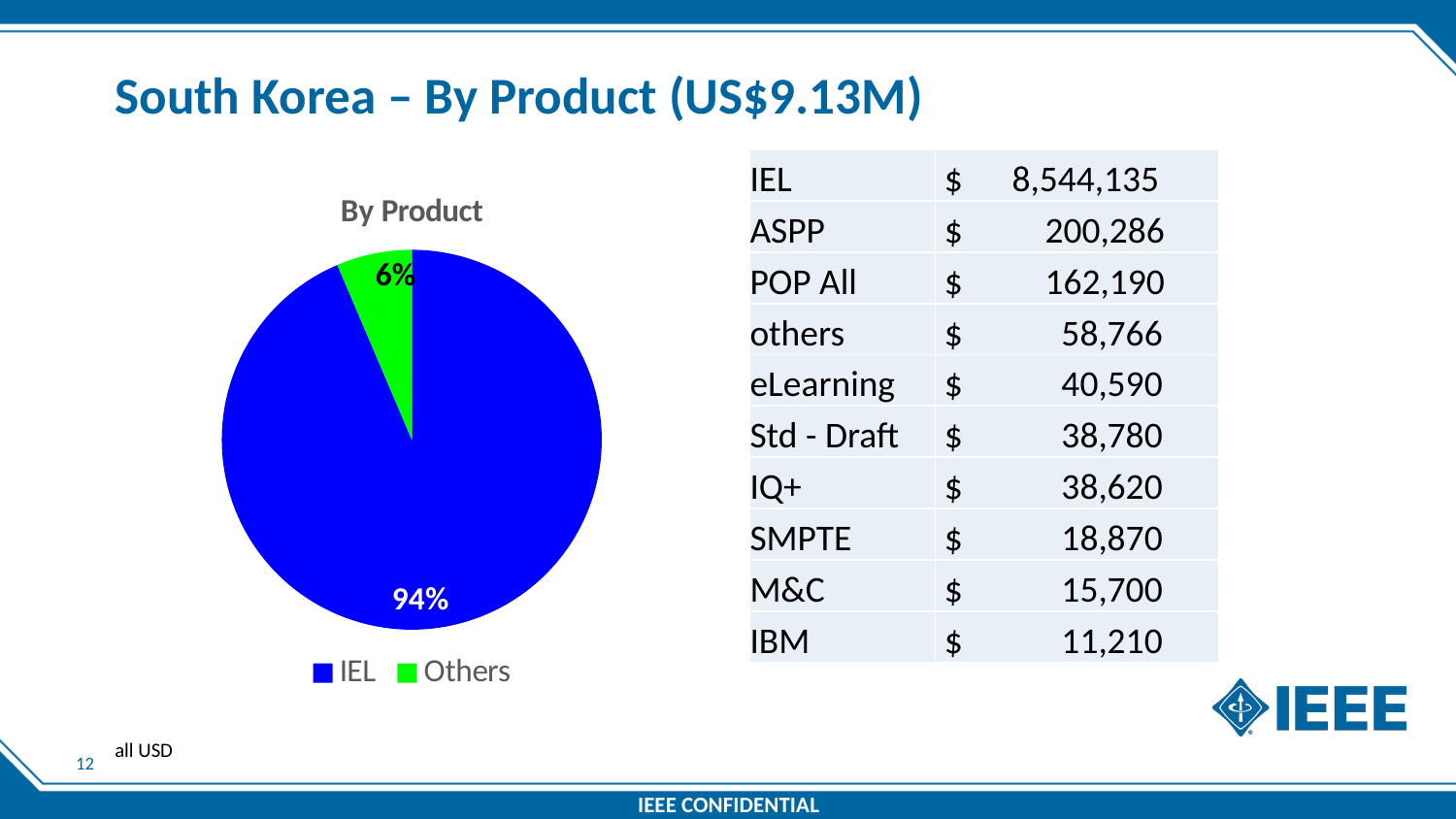
Which slice of the pie is the smallest? Others Which slice of the pie is the largest? IEL What colour is the IEL slice in the pie chart? blue What is the title of the chart? By Product What share of the pie does IEL account for? 94% What kind of chart is shown on the slide? pie chart What share of the pie does Others account for? 6% How many entries does the legend list? 2 How many slices does the pie chart have? 2 Which is larger, the IEL slice or the Others slice? IEL What is the difference in percentage points between the IEL slice and the Others slice? 88